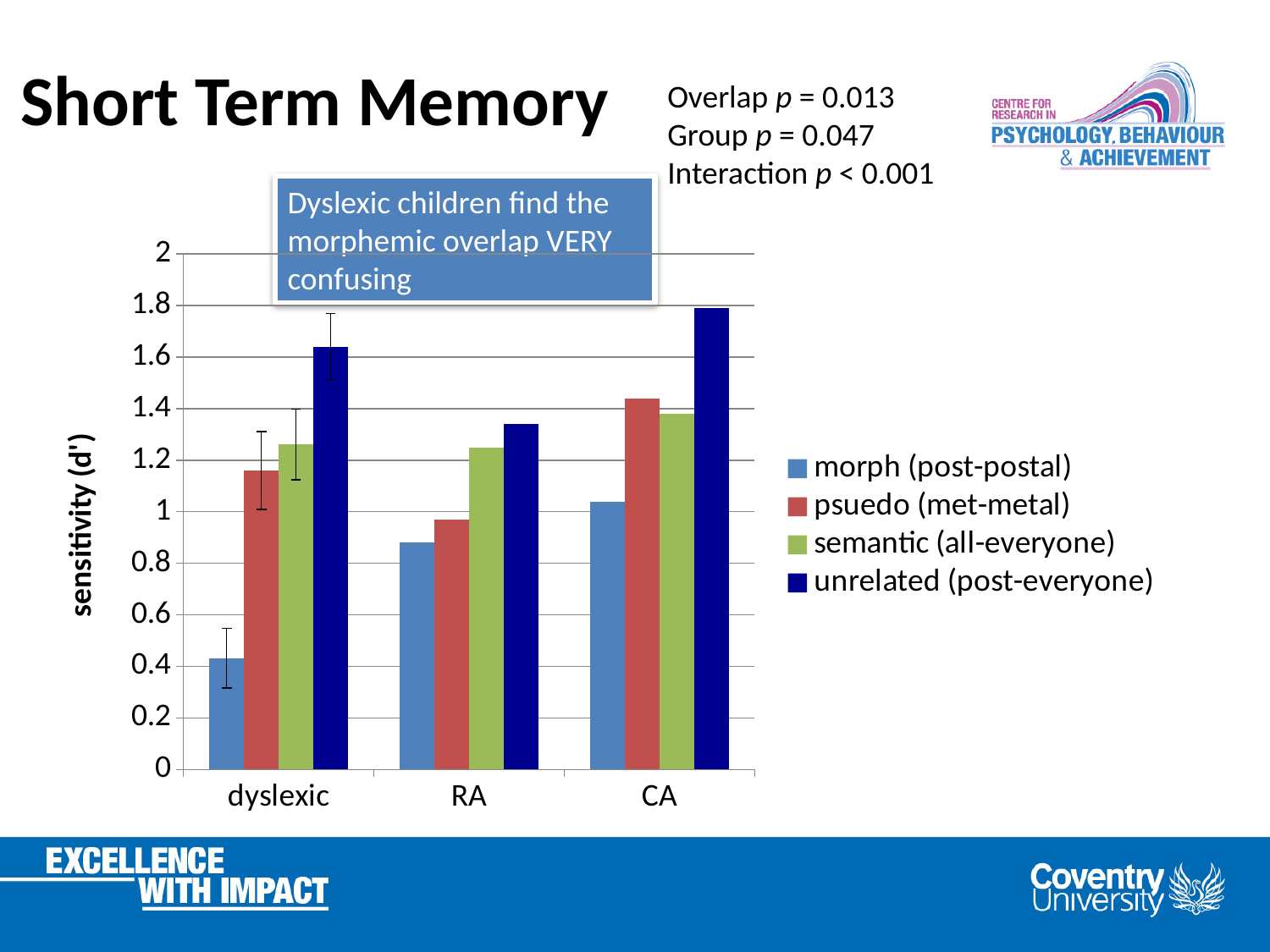
For the dyslexic group, which series has the highest sensitivity? unrelated (post-everyone) Is the morph (post-postal) value for the dyslexic group greater or less than 0.6? less Which bar is the shortest in the whole chart? morph (post-postal) for dyslexic Is the morph (post-postal) value for RA greater or less than 1? less Is the unrelated (post-everyone) value for CA greater or less than 1.6? greater How many groups are shown on the x axis of the chart? 3 How many series does the chart's legend list? 4 Which is larger: the unrelated (post-everyone) value for dyslexic or for RA? dyslexic Which series is shown in dark blue in the legend? unrelated (post-everyone) What kind of chart is shown on the slide? bar chart What is the label of the vertical axis? sensitivity (d') Which bar is the tallest in the whole chart? unrelated (post-everyone) for CA